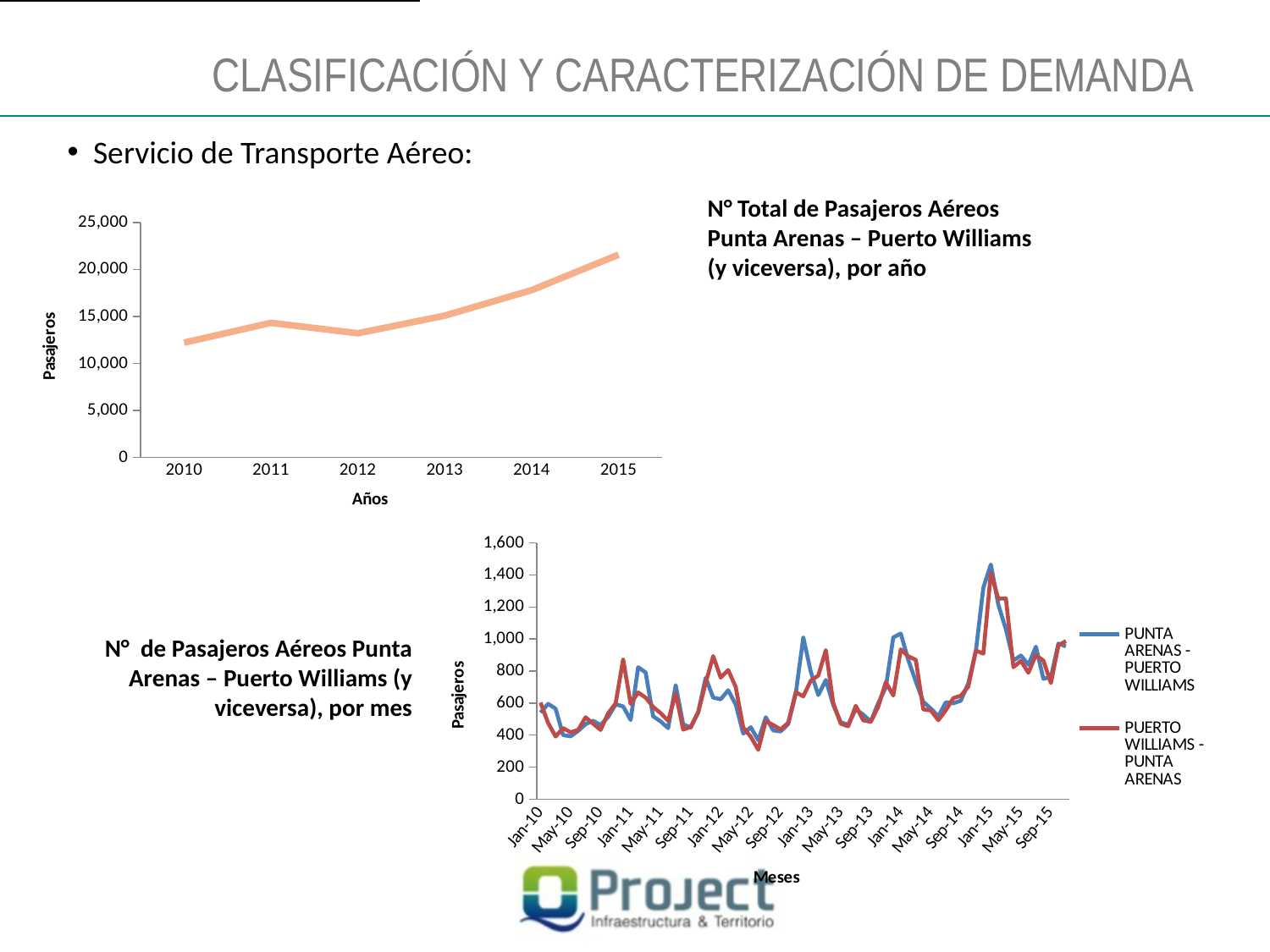
On the chart titled 'N° Total de Pasajeros Aéreos Punta Arenas – Puerto Williams (y viceversa), por año', is the value for 2015 greater or less than 20,000? greater On the chart titled 'N° Total de Pasajeros Aéreos Punta Arenas – Puerto Williams (y viceversa), por año', which year has the lowest number of passengers? 2010 On the chart titled 'N° Total de Pasajeros Aéreos Punta Arenas – Puerto Williams (y viceversa), por año', is the value for 2012 greater or less than 15,000? less On the chart titled 'N° Total de Pasajeros Aéreos Punta Arenas – Puerto Williams (y viceversa), por año', how many years are plotted on the x axis? 6 On the chart titled 'N° Total de Pasajeros Aéreos Punta Arenas – Puerto Williams (y viceversa), por año', is the value for 2014 greater or less than 15,000? greater On the chart titled 'N° de Pasajeros Aéreos Punta Arenas – Puerto Williams (y viceversa), por mes', what is the label of the blue series in the legend? PUNTA ARENAS - PUERTO WILLIAMS On the chart titled 'N° Total de Pasajeros Aéreos Punta Arenas – Puerto Williams (y viceversa), por año', do the values generally rise or fall from 2012 to 2015? rise On the chart titled 'N° Total de Pasajeros Aéreos Punta Arenas – Puerto Williams (y viceversa), por año', which is larger, the value for 2011 or the value for 2012? 2011 On the chart titled 'N° de Pasajeros Aéreos Punta Arenas – Puerto Williams (y viceversa), por mes', how many series does the legend list? 2 On the chart titled 'N° Total de Pasajeros Aéreos Punta Arenas – Puerto Williams (y viceversa), por año', which year has the highest number of passengers? 2015 On the chart titled 'N° Total de Pasajeros Aéreos Punta Arenas – Puerto Williams (y viceversa), por año', what kind of chart is shown? line chart